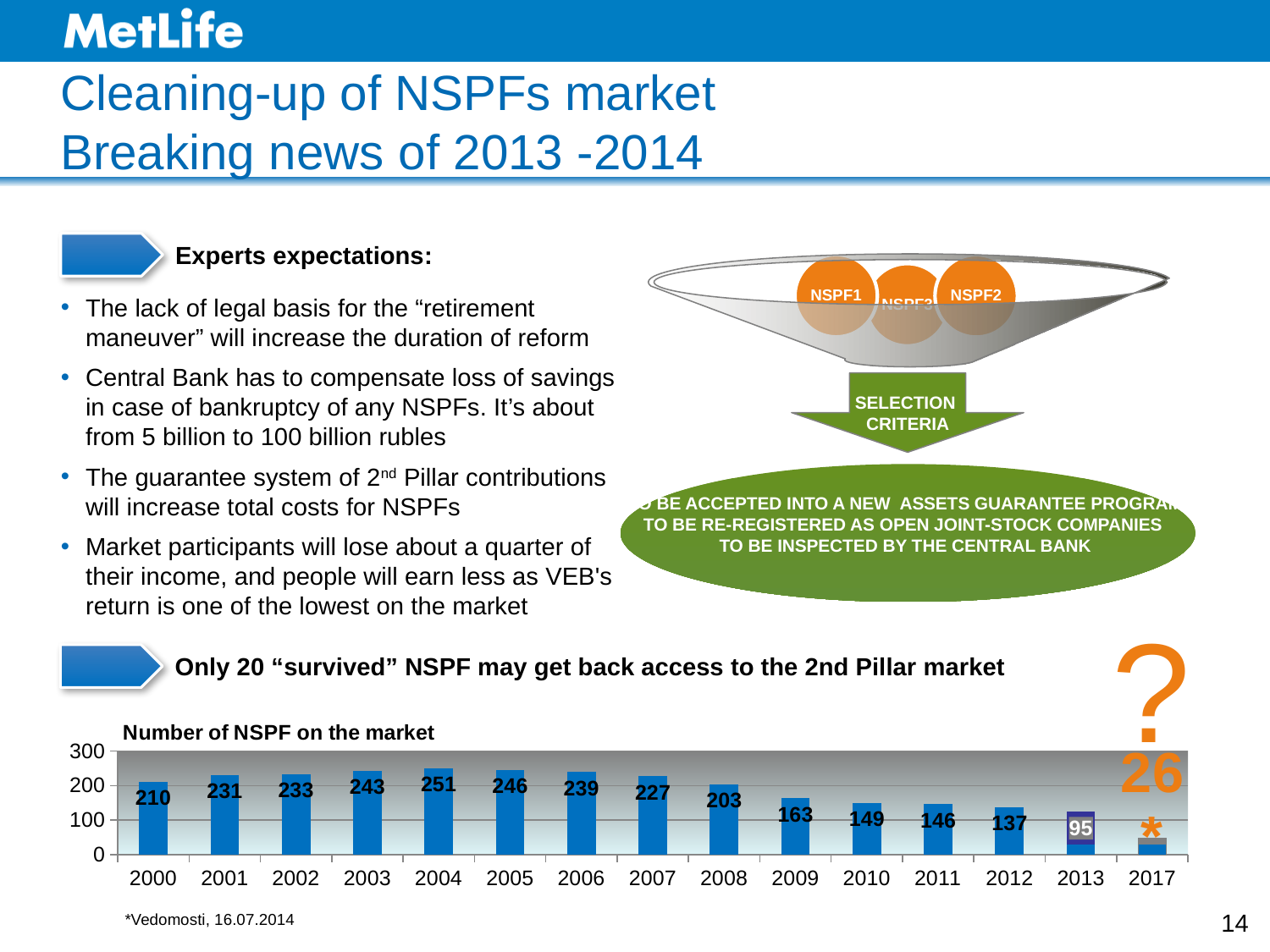
In the "Number of NSPF on the market" chart, is the value for 2012 greater or less than 200? less In the "Number of NSPF on the market" chart, what is the value for 2013? 95 Which year has the highest value in the "Number of NSPF on the market" chart? 2004 In the "Number of NSPF on the market" chart, which is larger, the value for 2001 or the value for 2008? 2001 What type of chart is "Number of NSPF on the market"? bar chart In the "Number of NSPF on the market" chart, what is the difference between the values for 2004 and 2013? 156 In the "Number of NSPF on the market" chart, what is the value for 2009? 163 How many years are shown on the x axis of the "Number of NSPF on the market" chart? 15 Among the years 2000 to 2013 in the "Number of NSPF on the market" chart, which year has the lowest value? 2013 In the "Number of NSPF on the market" chart, what is the value for 2004? 251 In the "Number of NSPF on the market" chart, do the values rise or fall from 2004 to 2013? fall